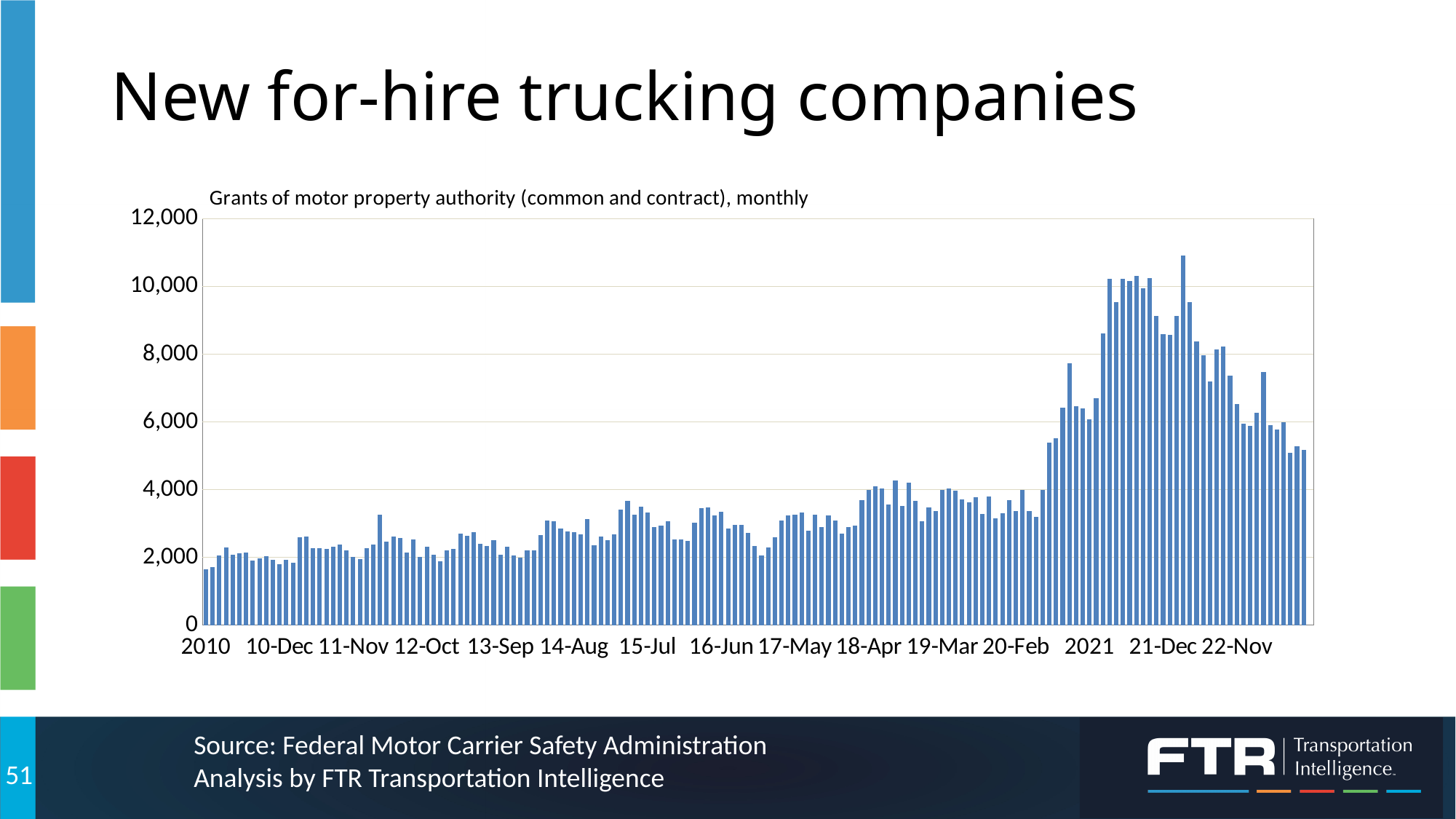
Which is larger, the value at 15-Jul or the value at 22-Nov? 22-Nov What is the subtitle printed above the chart? Grants of motor property authority (common and contract), monthly Do the values generally rise or fall from 2010 to 2021? rise Is the value for the bar at 15-Jul greater or less than 4,000? less Does the highest bar occur before or after the 2021 label on the x axis? after What kind of chart is shown on the slide? bar chart Is the value for the first bar at 2010 greater or less than 2,000? less Is the value for the bar at 2021 greater or less than 4,000? greater What is the highest value shown on the vertical axis? 12,000 Which is larger, the value at 2010 or the value at 2021? 2021